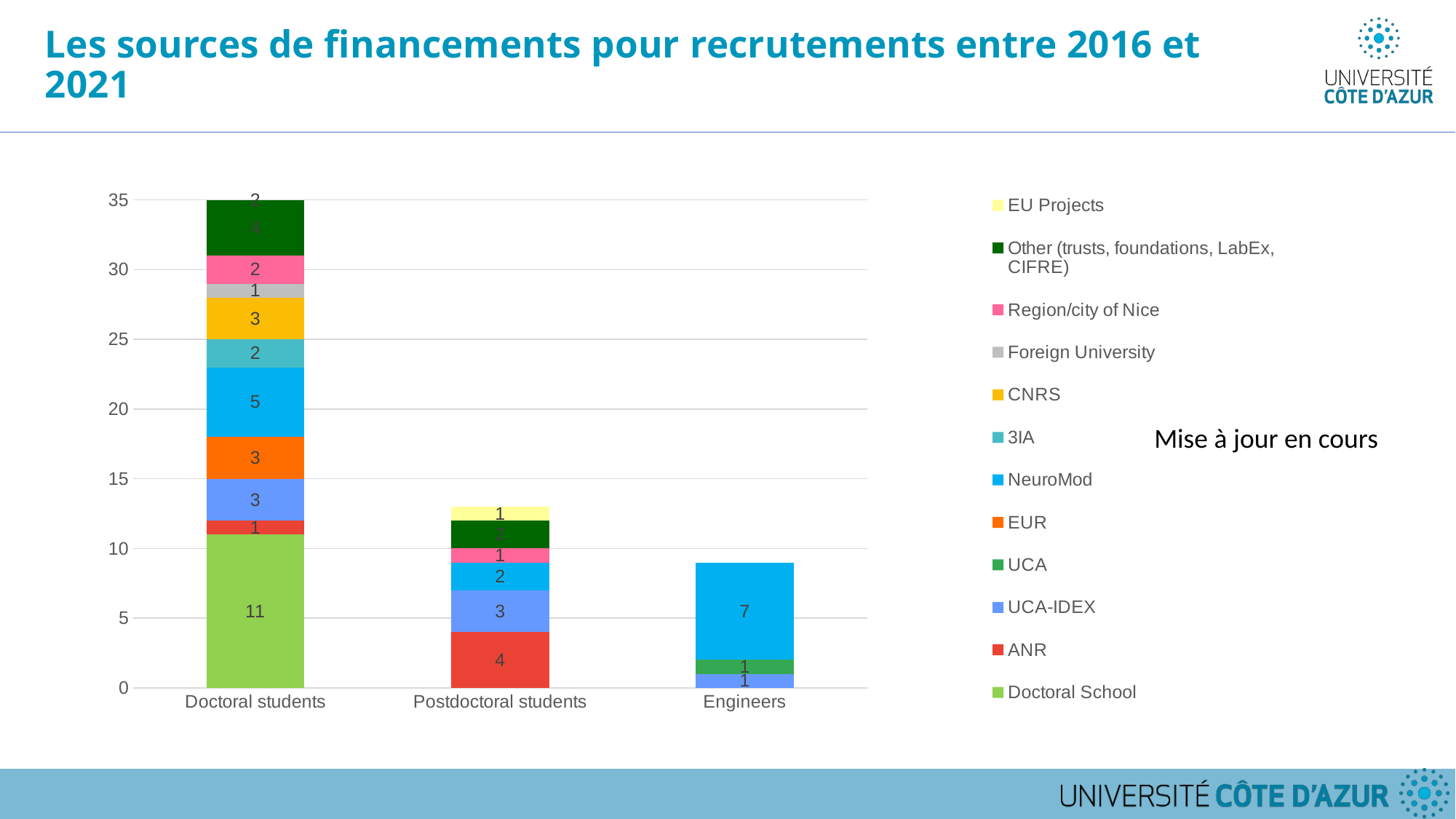
What is the total of the stacked bar for Engineers? 9 What is the difference between the NeuroMod value for Engineers and the NeuroMod value for Doctoral students? 2 What is the value of the NeuroMod segment for Engineers? 7 What is the value of the Doctoral School segment for Doctoral students? 11 Which category has a larger ANR value, Doctoral students or Postdoctoral students? Postdoctoral students What is the value of the CNRS segment for Doctoral students? 3 What is the total of the stacked bar for Postdoctoral students? 13 What kind of chart is shown on the slide? Stacked bar chart How many categories are shown on the x axis of the chart? 3 Which category has the shortest stacked bar? Engineers How many series does the chart's legend list? 12 What is the value of the ANR segment for Postdoctoral students? 4